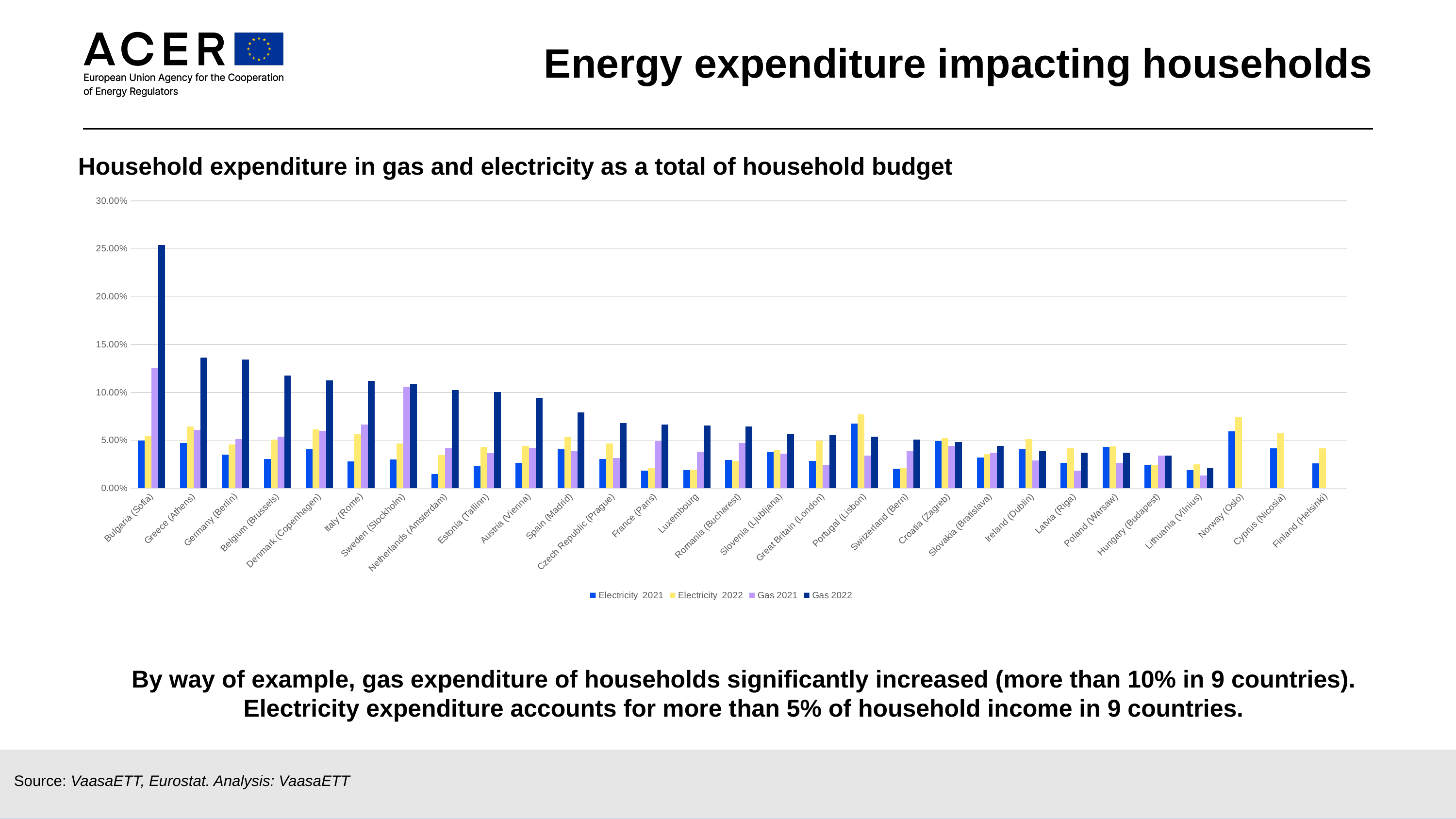
Do the Gas 2022 values generally rise or fall from left to right across the countries? fall How many series does the legend list? 4 Is the Electricity 2021 value for Lithuania (Vilnius) greater or less than 5.00%? less What kind of chart is shown on the slide? Bar chart Is the Electricity 2022 value for Norway (Oslo) greater or less than 5.00%? greater Which is larger for Portugal (Lisbon): the Electricity 2022 value or the Gas 2022 value? Electricity 2022 Is the Gas 2022 value for Greece (Athens) greater or less than 10.00%? greater How many countries are shown on the x axis of the chart? 29 Which is larger: the Gas 2022 value for Bulgaria (Sofia) or the Gas 2022 value for Greece (Athens)? Bulgaria (Sofia) Which country has the highest Gas 2022 value? Bulgaria (Sofia) What is the title of the chart? Household expenditure in gas and electricity as a total of household budget